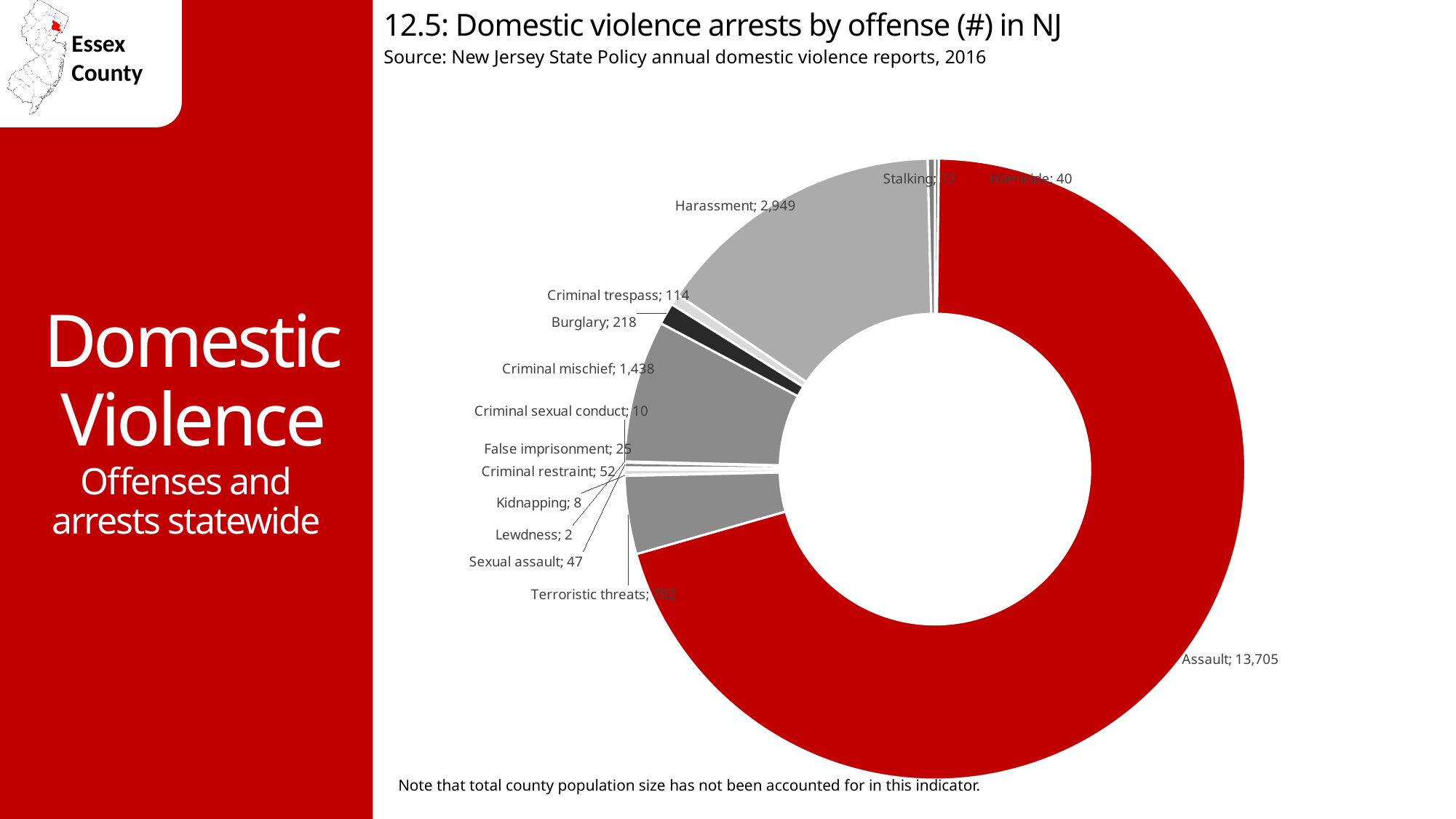
What is the difference between the values for Harassment and Criminal mischief? 1,511 Which is larger, the value for Stalking or the value for Criminal restraint? Stalking Which offense has the smallest number of arrests? Lewdness What is the value for Criminal mischief? 1,438 What is the difference between the values for Burglary and Criminal trespass? 104 What kind of chart is shown on the slide? doughnut chart What is the value for Harassment? 2,949 What is the title of the chart? 12.5: Domestic violence arrests by offense (#) in NJ Which offense has the largest number of arrests? Assault How many arrests are shown for Assault? 13,705 What is the value for Homicide? 40 What is the value for Burglary? 218